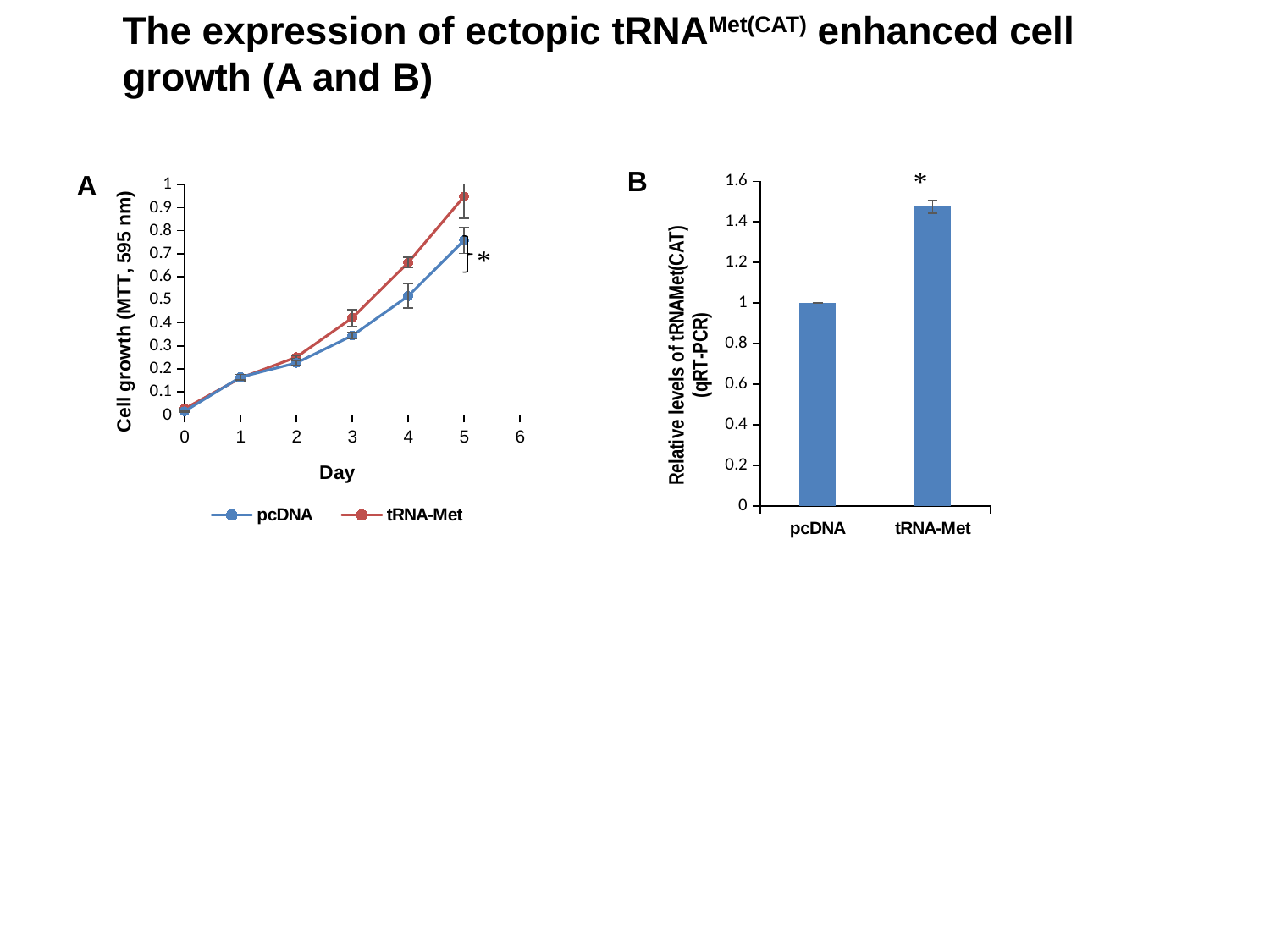
On chart A (left), is the value for tRNA-Met at day 5 greater or less than 0.8? greater On chart A (left), how many series does the legend list? 2 On chart A (left), what kind of chart is shown? line chart On chart A (left), at day 5, which series has the higher value, pcDNA or tRNA-Met? tRNA-Met On chart B (right), which category has the higher bar? tRNA-Met On chart B (right), is the value for tRNA-Met greater or less than 1.2? greater On chart A (left), how many data points are plotted for the tRNA-Met series? 6 On chart B (right), what kind of chart is shown? bar chart On chart A (left), do the values for tRNA-Met rise or fall as the day increases? rise On chart B (right), what is the relative level for pcDNA? 1 On chart A (left), is the value for pcDNA at day 4 greater or less than 0.6? less On chart B (right), how many categories are shown on the x axis? 2